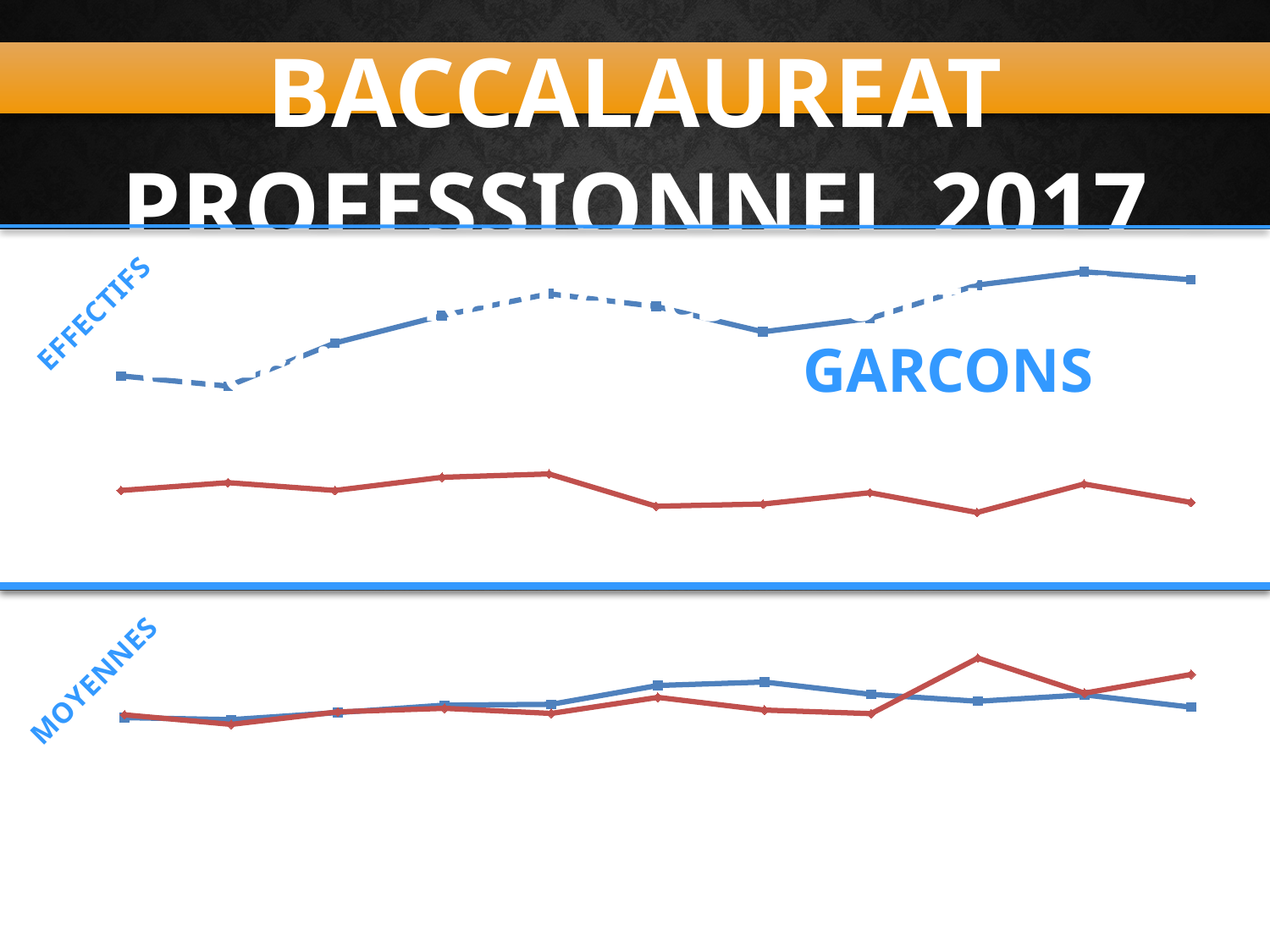
In the bottom chart labelled MOYENNES, does the red line overall rise or fall from left to right? rise What label is written in blue next to the top chart? EFFECTIFS What kind of chart is the bottom chart labelled MOYENNES? line chart In the top chart labelled EFFECTIFS, how many data points does the blue line have? 11 In the top chart labelled EFFECTIFS, is the lowest point of the blue line near the left end or the right end of the chart? the left end In the bottom chart labelled MOYENNES, how many data points does the red line have? 11 In the top chart labelled EFFECTIFS, does the blue line overall rise or fall from left to right? rise What kind of chart is the top chart labelled EFFECTIFS? line chart In the top chart labelled EFFECTIFS, how many lines are plotted? 2 What word is written in large blue letters inside the top chart area? GARCONS In the bottom chart labelled MOYENNES, at the rightmost point, which line is higher, the blue line or the red line? the red line In the top chart labelled EFFECTIFS, which line is higher across all points, the blue line or the red line? the blue line